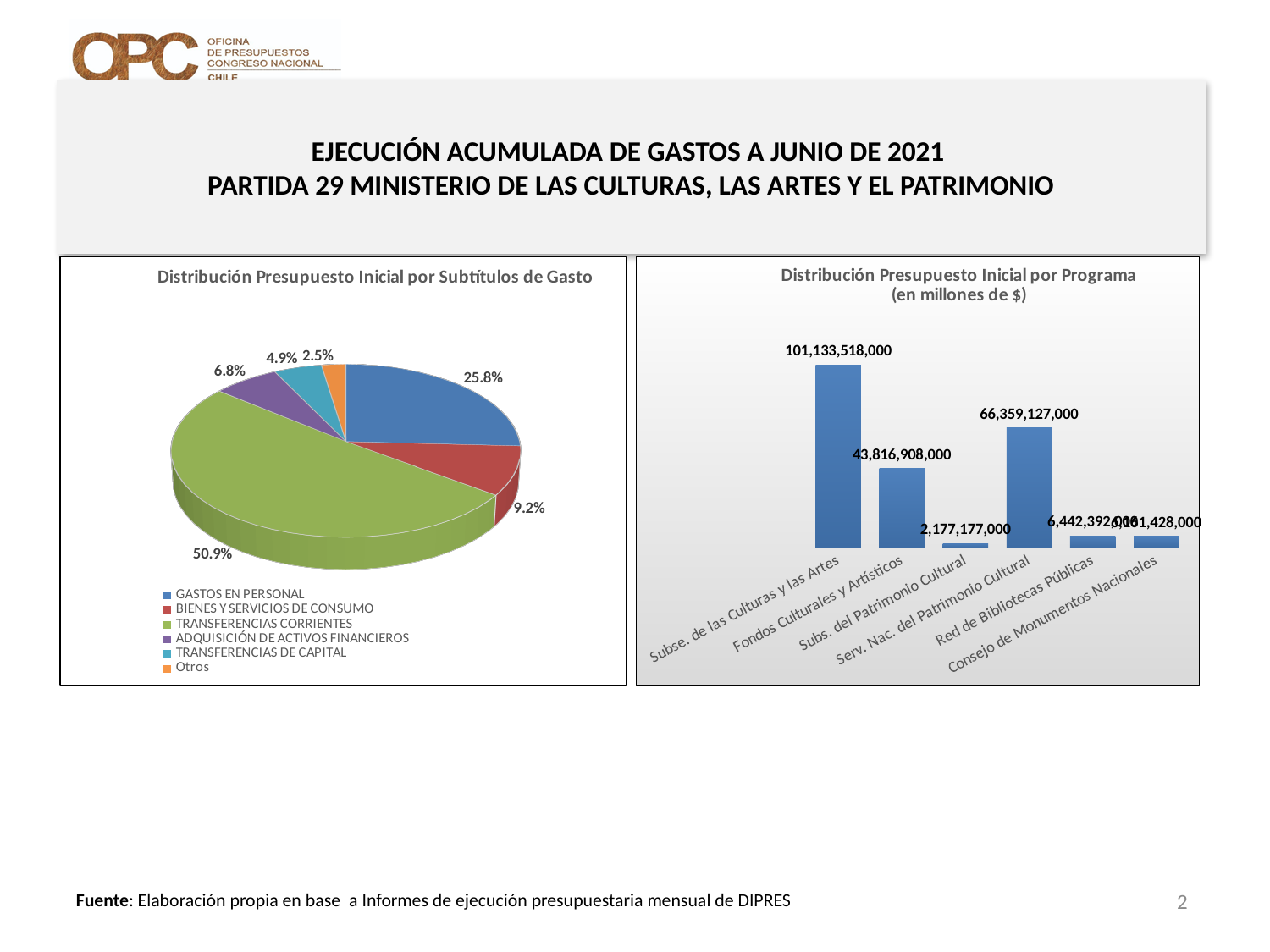
In the pie chart 'Distribución Presupuesto Inicial por Subtítulos de Gasto', which category has the smallest share? Otros What kind of chart is 'Distribución Presupuesto Inicial por Programa'? Bar chart In the pie chart 'Distribución Presupuesto Inicial por Subtítulos de Gasto', what share does TRANSFERENCIAS CORRIENTES have? 50.9% In the pie chart 'Distribución Presupuesto Inicial por Subtítulos de Gasto', how many categories does the legend list? 6 In the pie chart 'Distribución Presupuesto Inicial por Subtítulos de Gasto', which category has the largest share? TRANSFERENCIAS CORRIENTES In the pie chart 'Distribución Presupuesto Inicial por Subtítulos de Gasto', what share does GASTOS EN PERSONAL have? 25.8% In the pie chart 'Distribución Presupuesto Inicial por Subtítulos de Gasto', which is larger: ADQUISICIÓN DE ACTIVOS FINANCIEROS or TRANSFERENCIAS DE CAPITAL? ADQUISICIÓN DE ACTIVOS FINANCIEROS In the chart 'Distribución Presupuesto Inicial por Programa', which program has the lowest value? Subs. del Patrimonio Cultural In the chart 'Distribución Presupuesto Inicial por Programa', what is the value for Subse. de las Culturas y las Artes? 101,133,518,000 In the chart 'Distribución Presupuesto Inicial por Programa', what is the difference between Subse. de las Culturas y las Artes and Fondos Culturales y Artísticos? 57,316,610,000 In the chart 'Distribución Presupuesto Inicial por Programa', what is the value for Serv. Nac. del Patrimonio Cultural? 66,359,127,000 In the pie chart 'Distribución Presupuesto Inicial por Subtítulos de Gasto', what is the difference in percentage points between GASTOS EN PERSONAL and BIENES Y SERVICIOS DE CONSUMO? 16.6